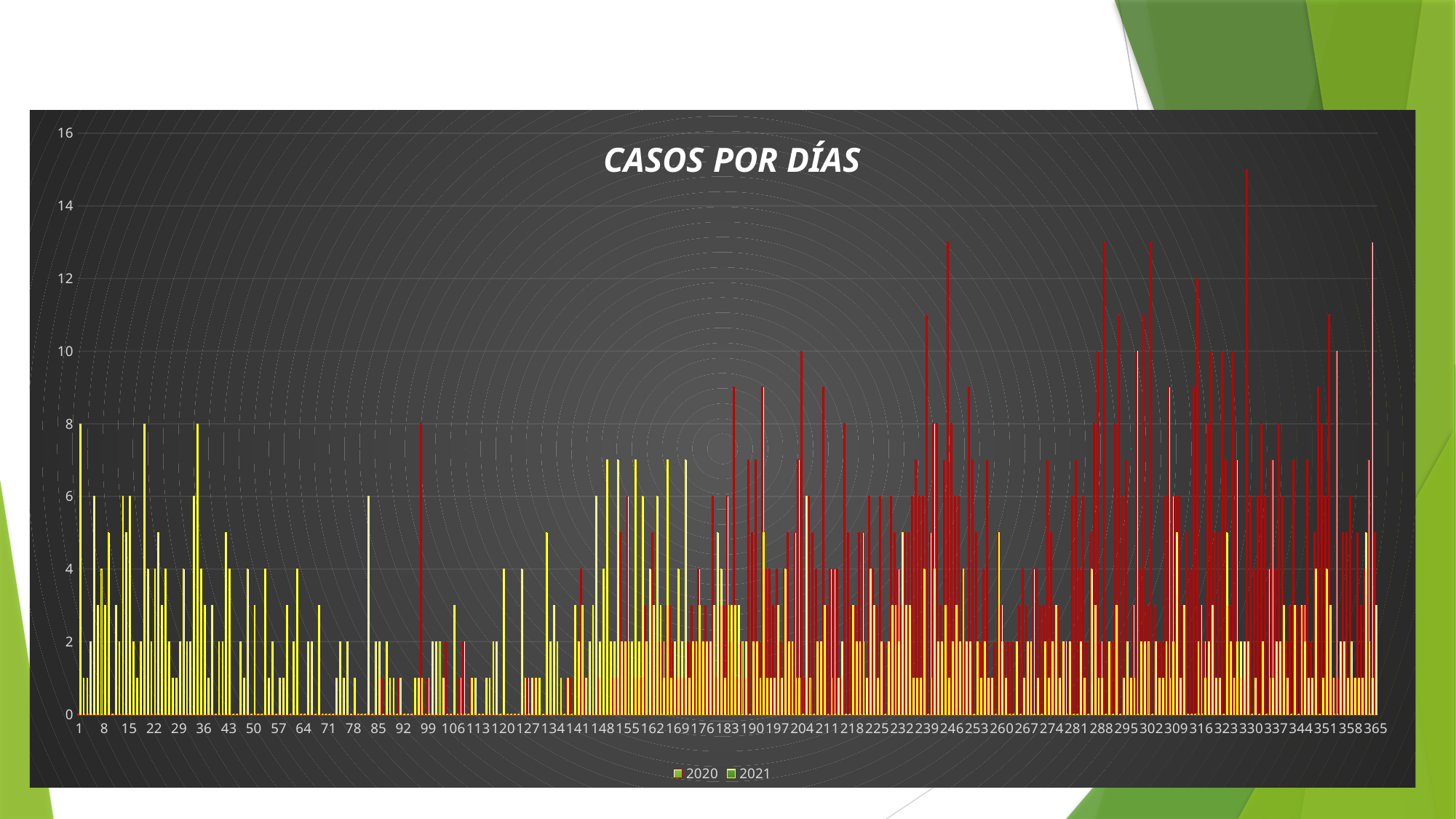
Which series reaches the highest single value in the chart, 2020 or 2021? 2020 Is the highest value for the 2021 series greater or less than 10? less Is the highest value for the 2020 series greater or less than 14? greater What kind of chart is shown on the slide? bar chart How many series does the legend list? 2 Which series is drawn in red? 2020 What is the highest value shown on the vertical axis? 16 What is the last label on the horizontal axis? 365 Around day 330, which series has the higher value, 2020 or 2021? 2020 Do the values for the 2020 series generally rise or fall along the x axis? rise What is the title of the chart? CASOS POR DÍAS In the first 100 days, which series has the higher values, 2020 or 2021? 2021